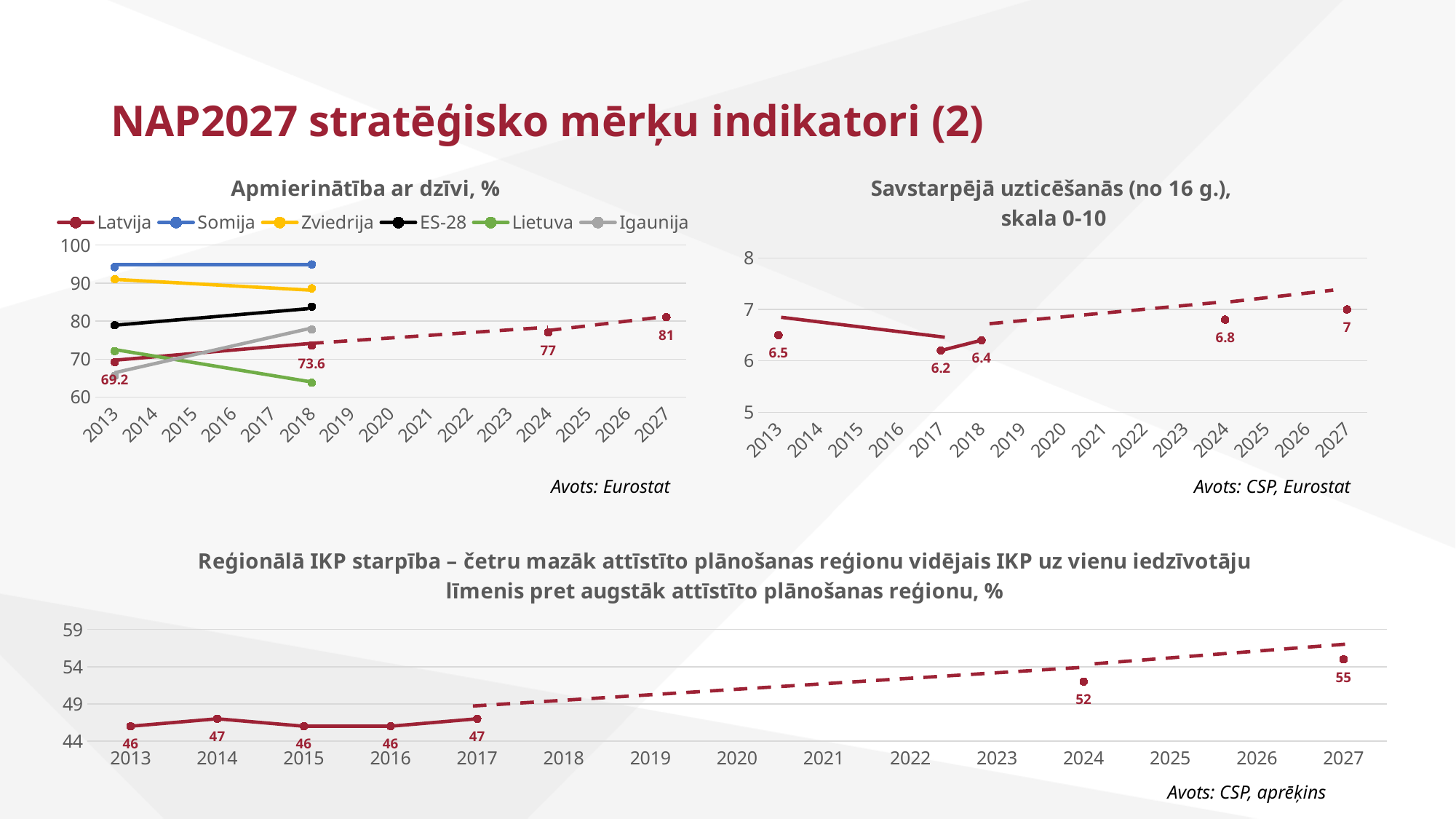
In the chart 'Apmierinātība ar dzīvi, %', by how much does the Latvija value rise from 2018 to 2027? 7.4 In the bottom chart on regional GDP difference (Reģionālā IKP starpība), what is the difference between the 2027 value and the 2017 value? 8 In the chart 'Apmierinātība ar dzīvi, %', what is the value for Latvija in 2013? 69.2 In the chart 'Apmierinātība ar dzīvi, %', which country has the highest value in 2018? Somija In the chart 'Apmierinātība ar dzīvi, %', is the value for Somija in 2018 greater or less than 90? greater In the chart 'Savstarpējā uzticēšanās (no 16 g.), skala 0-10', what is the value in 2017? 6.2 In the chart 'Savstarpējā uzticēšanās (no 16 g.), skala 0-10', what is the target value for 2027? 7 In the chart 'Apmierinātība ar dzīvi, %', how many series does the legend list? 6 In the chart 'Savstarpējā uzticēšanās (no 16 g.), skala 0-10', which year has the lowest labelled value? 2017 What type of chart is the bottom chart on regional GDP difference (Reģionālā IKP starpība)? Line chart In the chart 'Apmierinātība ar dzīvi, %', what is the value for Latvija in 2018? 73.6 In the bottom chart on regional GDP difference (Reģionālā IKP starpība), what is the value in 2024? 52